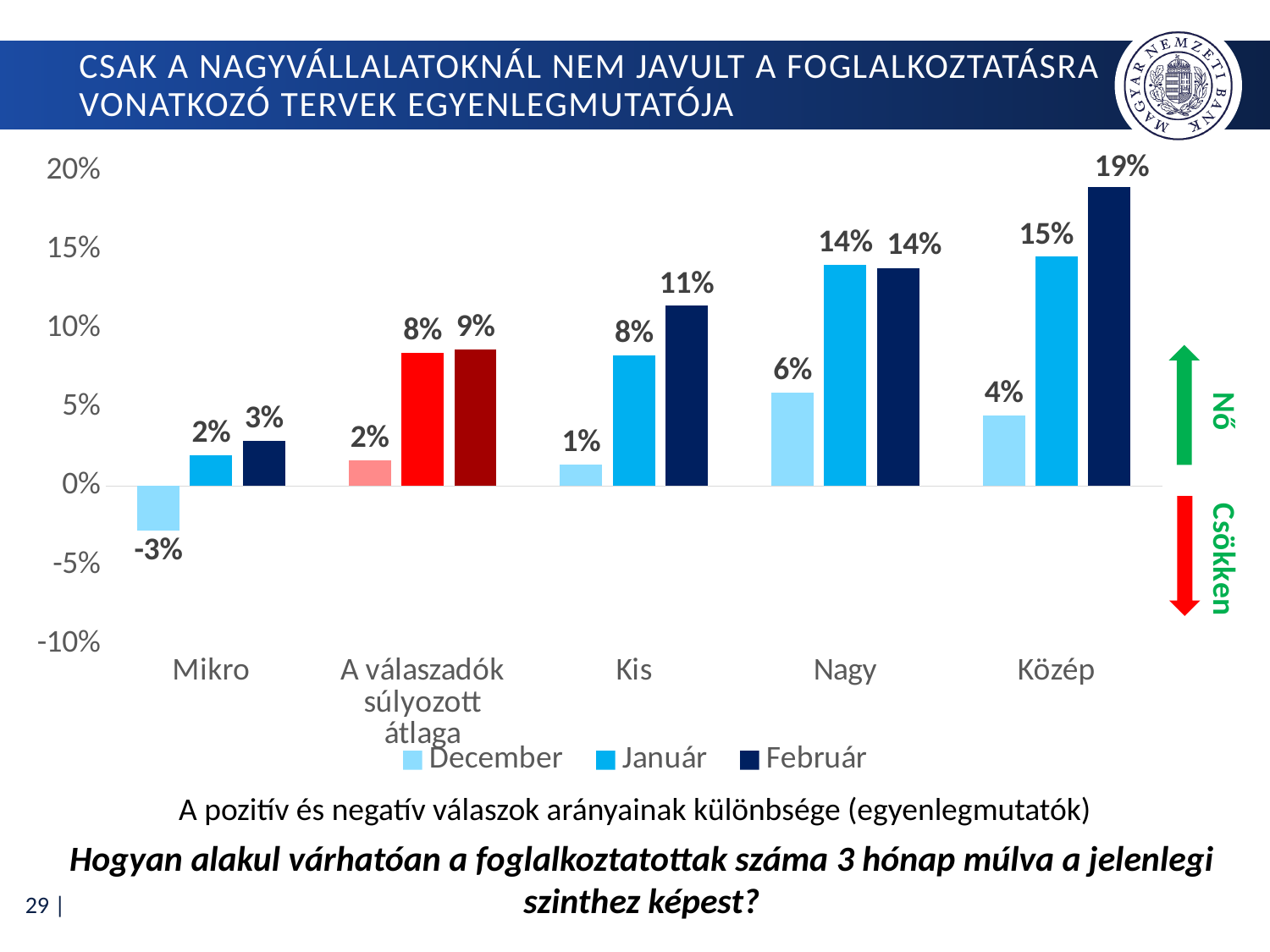
What is the December value for Mikro? -3% For Nagy, do the values rise or fall from December to Január? Rise What kind of chart is shown on the slide? Bar chart What is the Február value for Kis? 11% Which category has the lowest December value? Mikro How many series does the legend list? 3 What is the Január value for Nagy? 14% Which is larger for Kis: the Január value or the Február value? Február Which category has the highest Február value? Közép What is the Február value for Közép? 19% How many categories are shown on the x axis? 5 What is the difference between the Február and December values for Közép? 15%